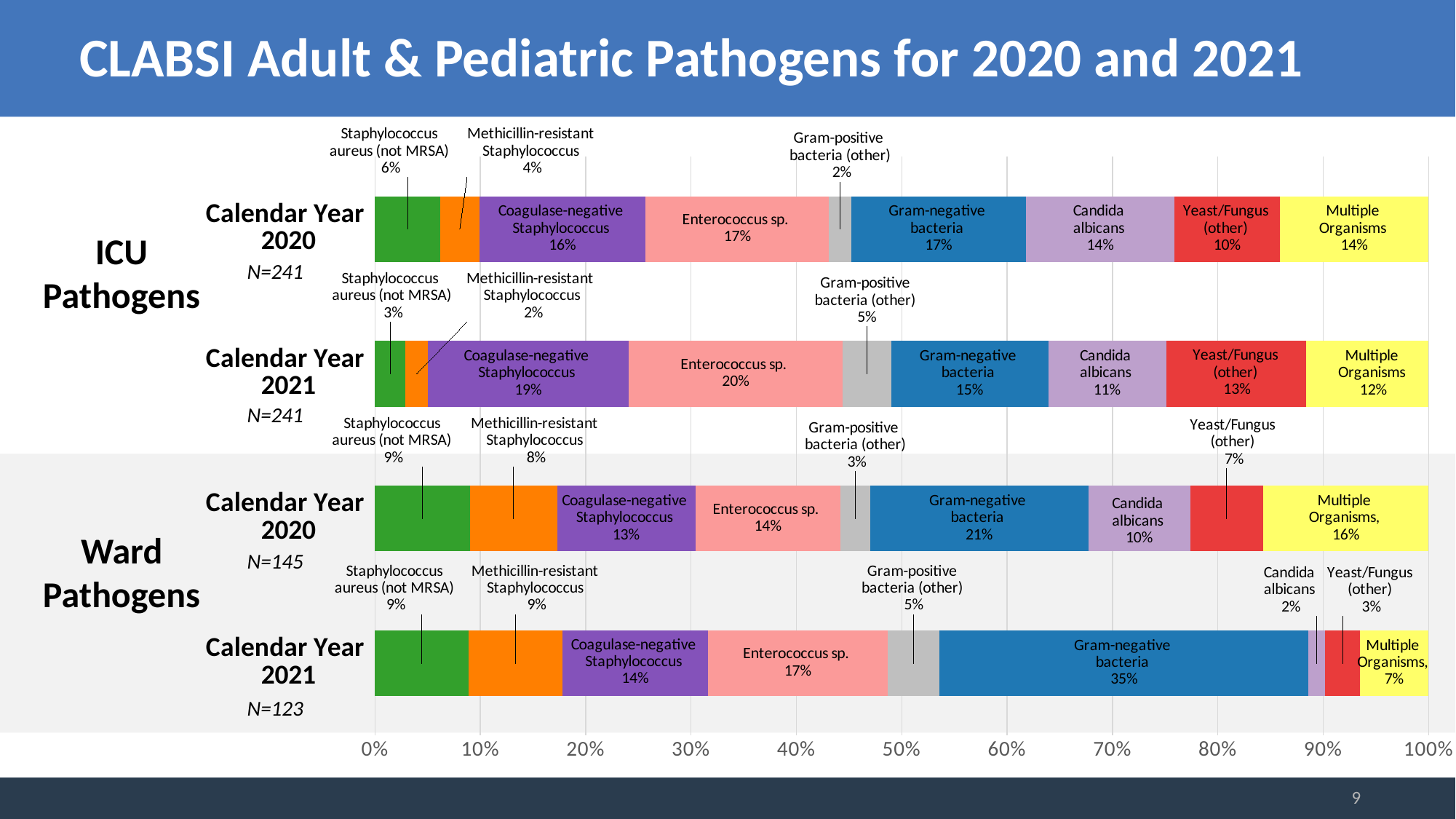
By how many percentage points did the Gram-negative bacteria share of Ward pathogens change from Calendar Year 2020 to Calendar Year 2021? 14 percentage points Which pathogen category had the smallest share of ICU pathogens in Calendar Year 2020? Gram-positive bacteria (other) What is the N value for Ward Pathogens in Calendar Year 2021? N=123 What percentage of Ward pathogens in Calendar Year 2021 were Gram-negative bacteria? 35% What is the N value for ICU Pathogens in Calendar Year 2020? N=241 What percentage of Ward pathogens in Calendar Year 2020 were Methicillin-resistant Staphylococcus? 8% What percentage of ICU pathogens in Calendar Year 2020 were Gram-negative bacteria? 17% How many bars (calendar year groups) are shown in the chart? 4 What share of ICU pathogens in Calendar Year 2021 was Enterococcus sp.? 20% Which pathogen category had the largest share of Ward pathogens in Calendar Year 2021? Gram-negative bacteria What type of chart is shown on the slide? Stacked bar chart Was the Candida albicans share of ICU pathogens higher in Calendar Year 2020 or Calendar Year 2021? Calendar Year 2020